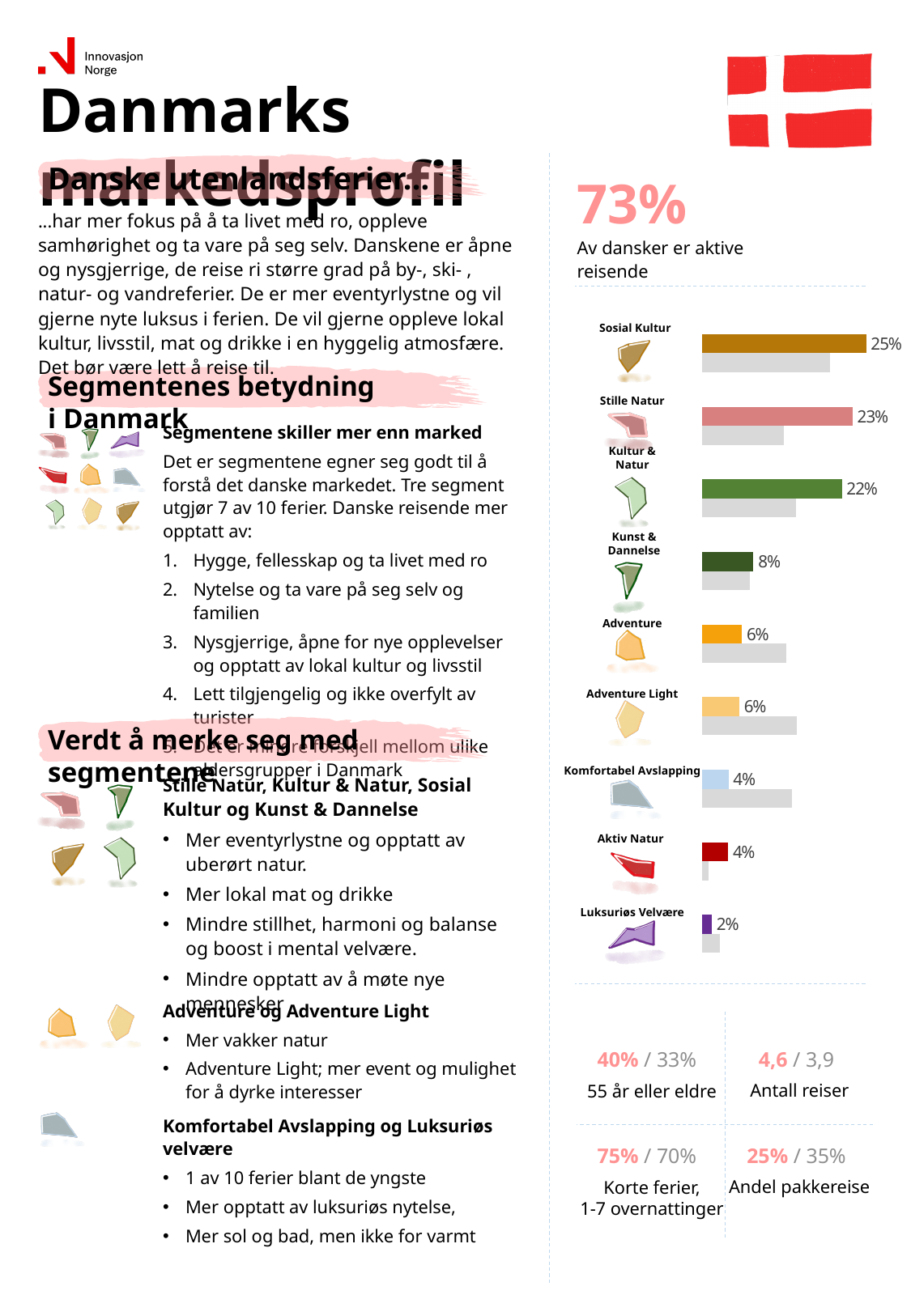
What is the value for Kunst & Dannelse in the bar chart? 8% What is the value for Stille Natur in the bar chart? 23% What is the value for Luksuriøs Velvære in the bar chart? 2% Which segment has the highest value in the bar chart? Sosial Kultur What is the difference between the values for Sosial Kultur and Kunst & Dannelse in the bar chart? 17% What is the value for Kultur & Natur in the bar chart? 22% Which segment has the lowest value in the bar chart? Luksuriøs Velvære What kind of chart is used to show the segment values? Bar chart How many segments are shown in the bar chart? 9 Which has a larger value in the bar chart, Stille Natur or Adventure? Stille Natur What is the value for Sosial Kultur in the bar chart? 25% What is the difference between the values for Kultur & Natur and Aktiv Natur in the bar chart? 18%